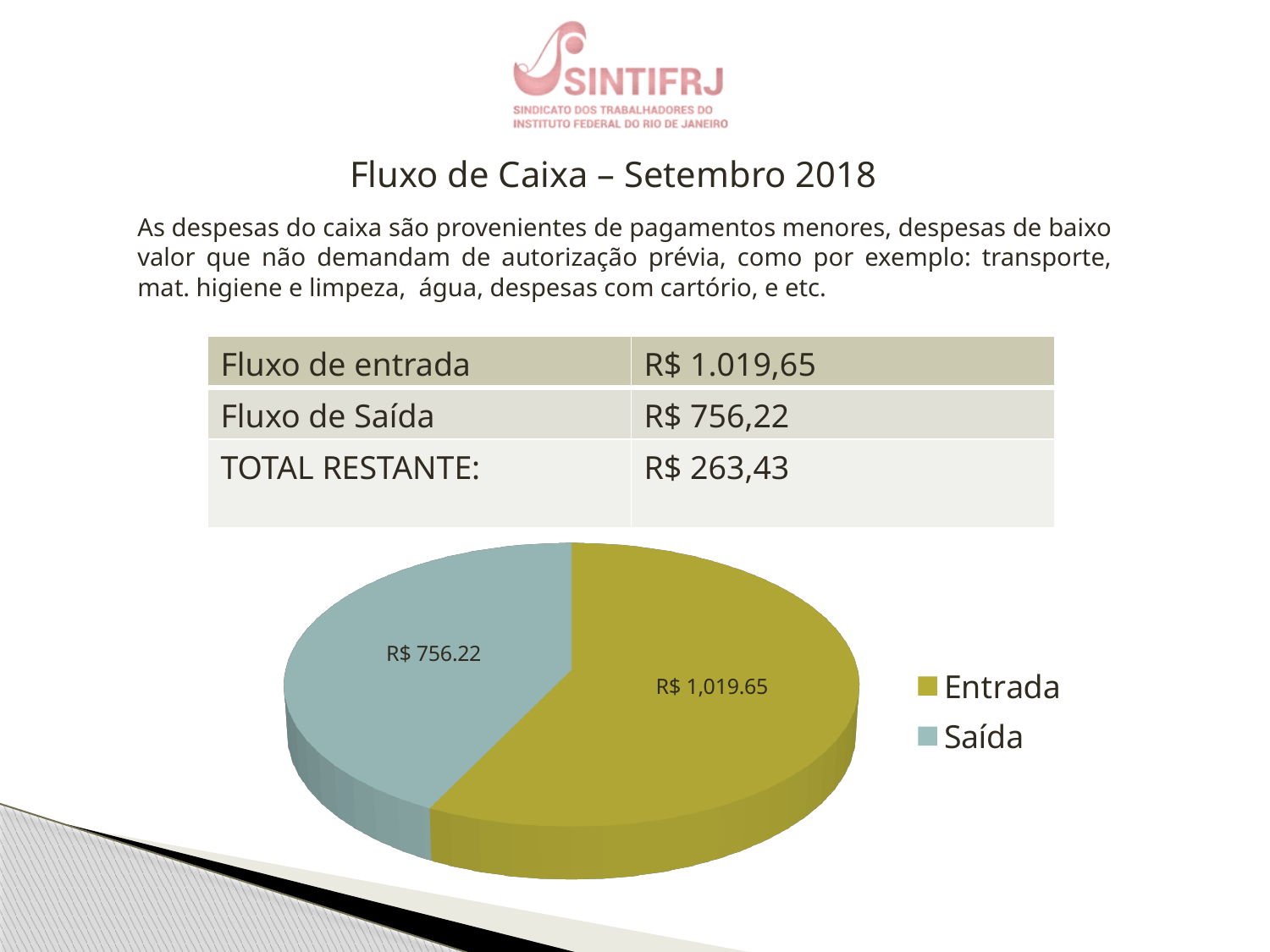
What is the value of the Entrada slice in the pie chart? R$ 1,019.65 What colour is the Saída slice in the pie chart? Blue-grey What are the two legend entries of the pie chart? Entrada and Saída How many slices does the pie chart have? 2 How many entries does the pie chart's legend list? 2 Which slice of the pie chart is the largest? Entrada Which is larger in the pie chart, Entrada or Saída? Entrada What is the value of the Saída slice in the pie chart? R$ 756.22 What is the difference between the Entrada and Saída values in the pie chart? R$ 263.43 What kind of chart is shown on the slide? Pie chart What is the total of the two slices in the pie chart? R$ 1,775.87 Which slice of the pie chart is the smallest? Saída